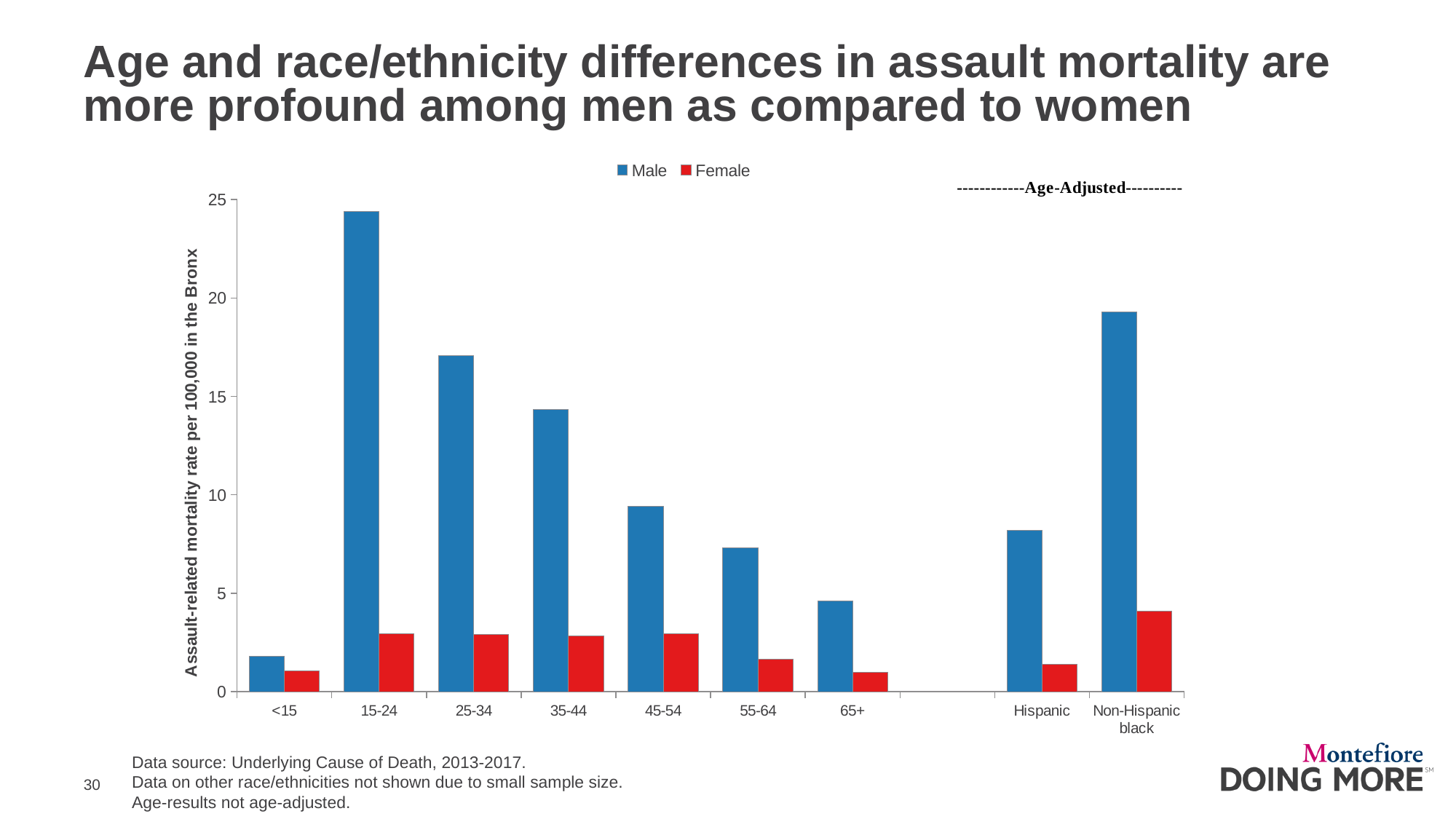
Is the Male value for 15-24 greater or less than 20? greater How many series does the legend list? 2 Do the Male values rise or fall across the age groups from 15-24 to 65+? fall What colour are the Female bars? red Is the Male value for Non-Hispanic black greater or less than 20? less Which is larger, the Male value for 25-34 or the Male value for 35-44? 25-34 Which category has the highest Male value? 15-24 Which category has the highest Female value? Non-Hispanic black Which category has the lowest Male value? <15 What kind of chart is shown on the slide? bar chart Is the Female value for Non-Hispanic black greater or less than 5? less How many categories are shown on the x axis? 9